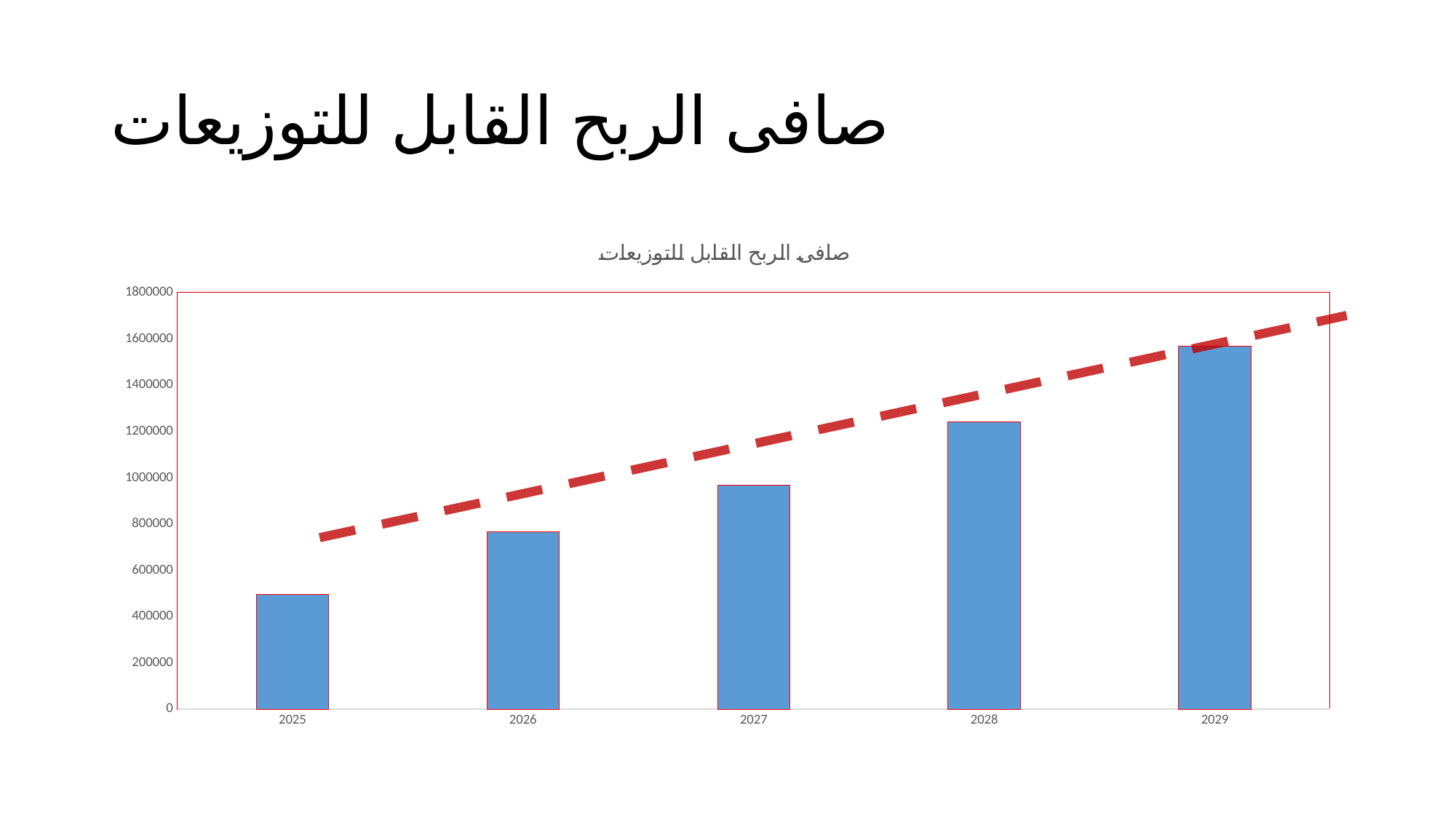
How many years are shown on the x axis of the chart? 5 Is the value for 2028 greater or less than 1000000? greater What is the title of the chart? صافى الربح القابل للتوزيعات Is the value for 2025 greater or less than 600000? less Is the value for 2029 greater or less than 1400000? greater Which year has the larger value, 2026 or 2028? 2028 Do the bar values rise or fall from 2025 to 2029? Rise What kind of chart is shown on the slide? Bar chart Which year has the highest bar in the chart? 2029 Which year has the lowest bar in the chart? 2025